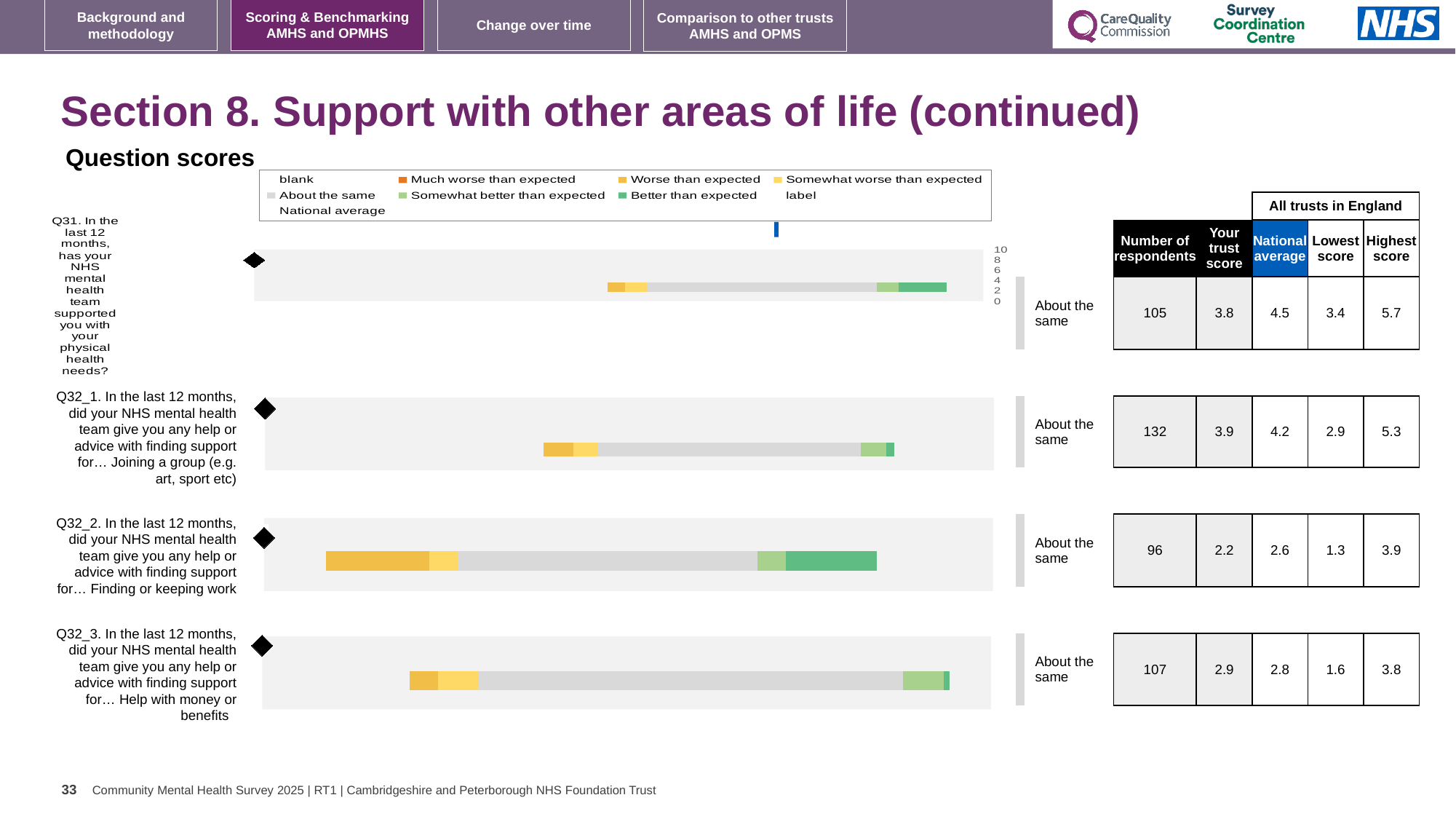
For Q31, what is the difference between the highest score (5.7) and the lowest score (3.4) in the table beside the chart? 2.3 In the table beside the chart, what is the national average for Q32_1 (Joining a group)? 4.2 How many questions (bars) are plotted in the question scores chart? 4 In the chart legend, what colour represents "Much worse than expected"? orange What kind of chart is used to show the question scores on this slide? bar chart Which question's bar has the largest "Worse than expected" (orange-yellow) segment? Q32_2 (Finding or keeping work) For Q32_3 (Help with money or benefits), which is larger: your trust score or the national average? your trust score Which question has the highest number of respondents in the table beside the chart? Q32_1 (Joining a group) In the table beside the chart, what is your trust score for Q32_2 (Finding or keeping work)? 2.2 In the chart legend, what colour represents "Better than expected"? green In the table beside the chart, what is the number of respondents for Q31 (physical health needs)? 105 Which question has the lowest trust score in the table beside the chart? Q32_2 (Finding or keeping work)